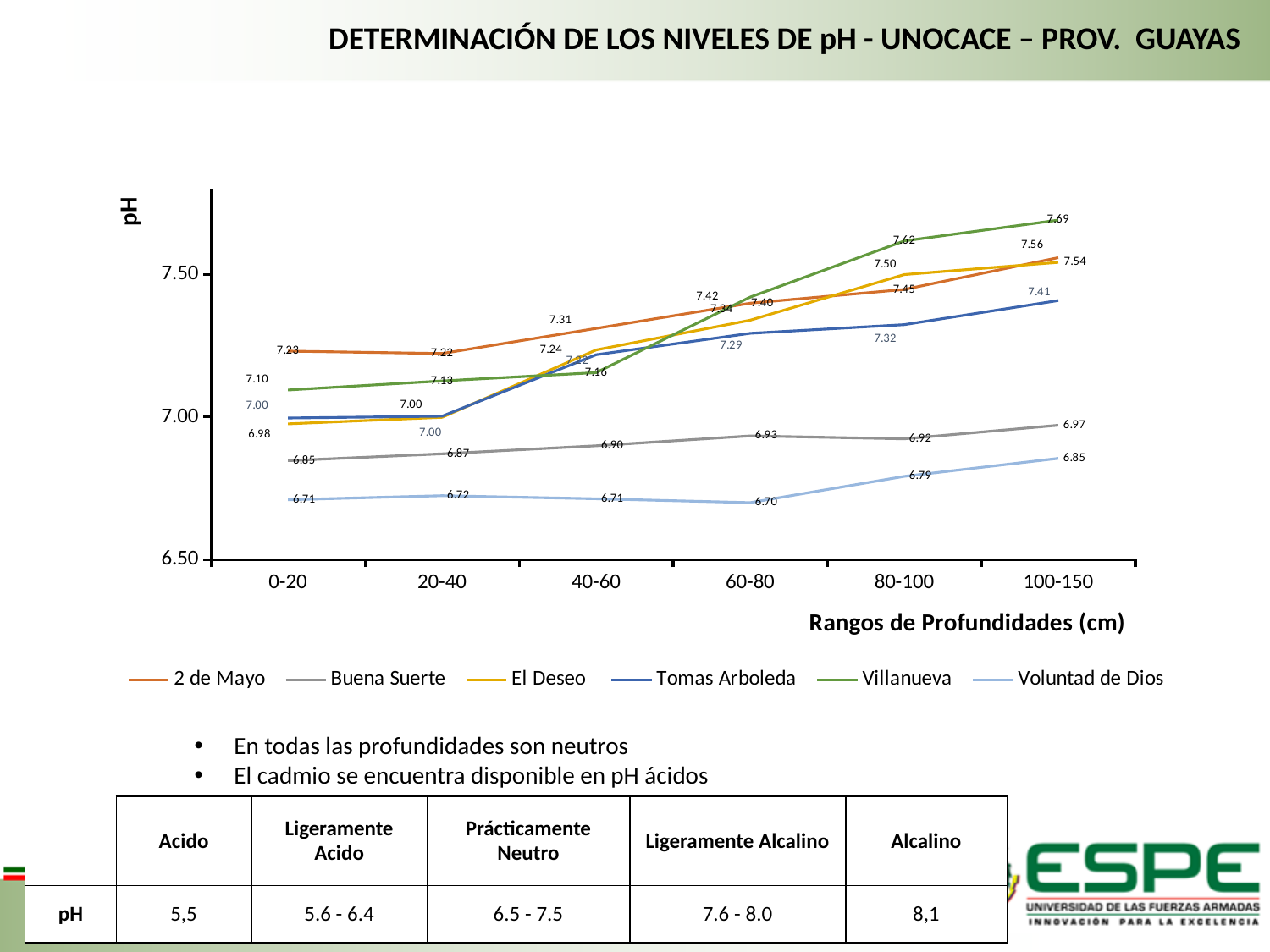
What is the pH value for Villanueva at the 100-150 depth range? 7.69 What is the difference between the pH of Villanueva and Voluntad de Dios at the 100-150 depth range? 0.84 What is the pH value for Buena Suerte at the 100-150 depth range? 6.97 What is the pH value for Voluntad de Dios at the 60-80 depth range? 6.70 Which series has the highest pH at the 100-150 depth range? Villanueva Which series has the lowest pH at the 0-20 depth range? Voluntad de Dios What is the pH value for 2 de Mayo at the 0-20 depth range? 7.23 How many depth ranges are shown on the x axis? 6 How many series does the legend list? 6 What is the pH value for Tomas Arboleda at the 80-100 depth range? 7.32 What kind of chart is shown on the slide? Line chart At the 60-80 depth range, which has a higher pH: Buena Suerte or Voluntad de Dios? Buena Suerte